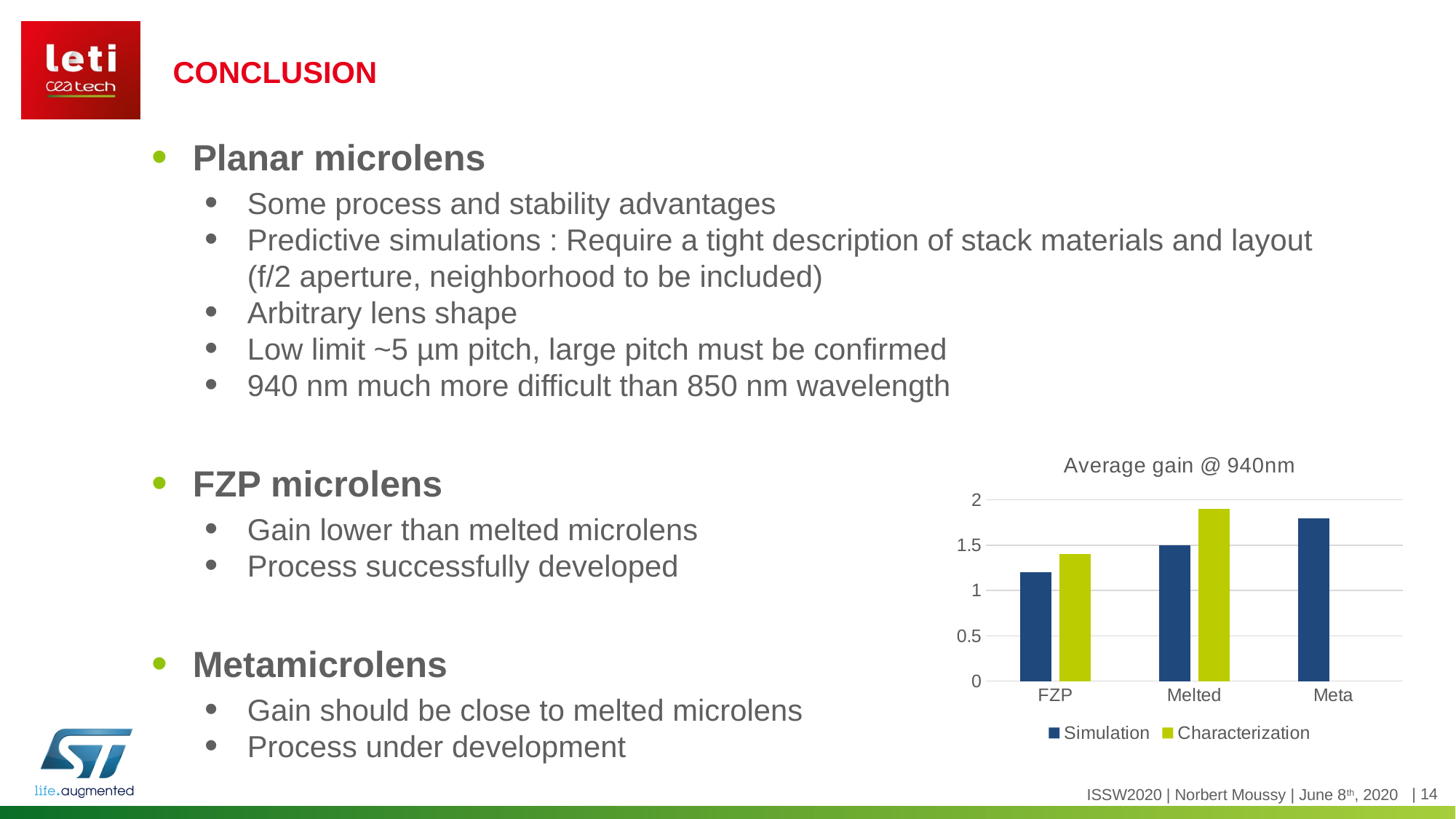
Which category has the lowest Simulation bar? FZP Is the Simulation value for Meta greater or less than 1.5? greater What kind of chart is shown on the slide? bar chart Which category has no Characterization bar? Meta How many categories are shown on the x axis of the chart? 3 For FZP, which is larger: the Simulation value or the Characterization value? Characterization Is the Simulation value for FZP greater or less than 1? greater Which category has the highest Characterization bar? Melted How many series does the chart legend list? 2 Is the Characterization value for FZP greater or less than 1.5? less What is the title of the chart? Average gain @ 940nm